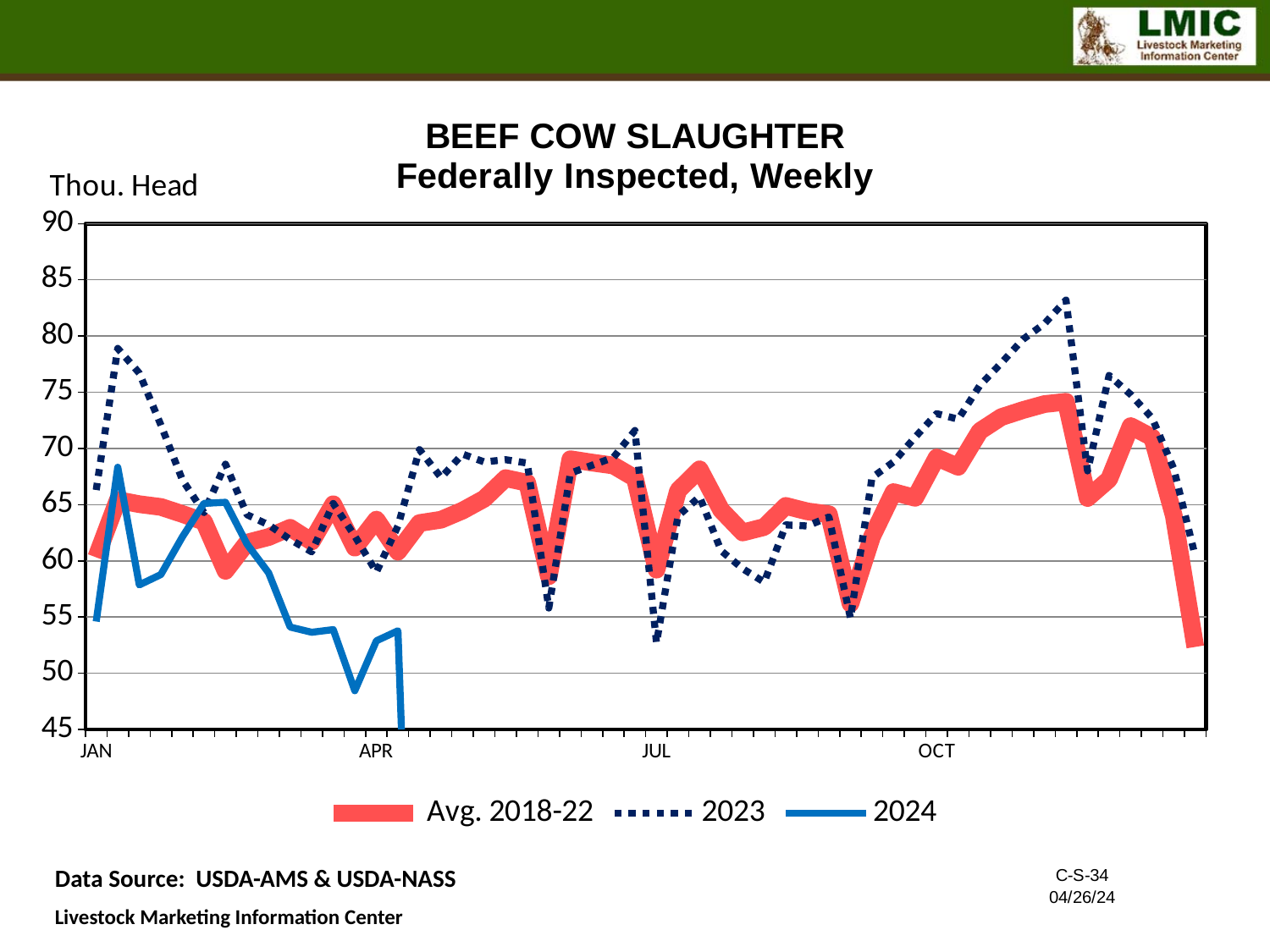
Is the value of the Avg. 2018-22 series at the end of December greater or less than 55? less What is the unit label shown above the y axis? Thou. Head In early April, which series is higher: Avg. 2018-22 or 2024? Avg. 2018-22 What are the three series listed in the legend? Avg. 2018-22, 2023, 2024 Is the lowest value of the 2024 series in early April greater or less than 50? less Is the peak value of the 2023 series in November greater or less than 80? greater What kind of chart is shown on the slide? line chart How many series does the legend list? 3 Does the 2024 series generally rise or fall from January to April? fall Which series reaches the highest value anywhere on the chart? 2023 In early January, which series is higher: 2023 or 2024? 2023